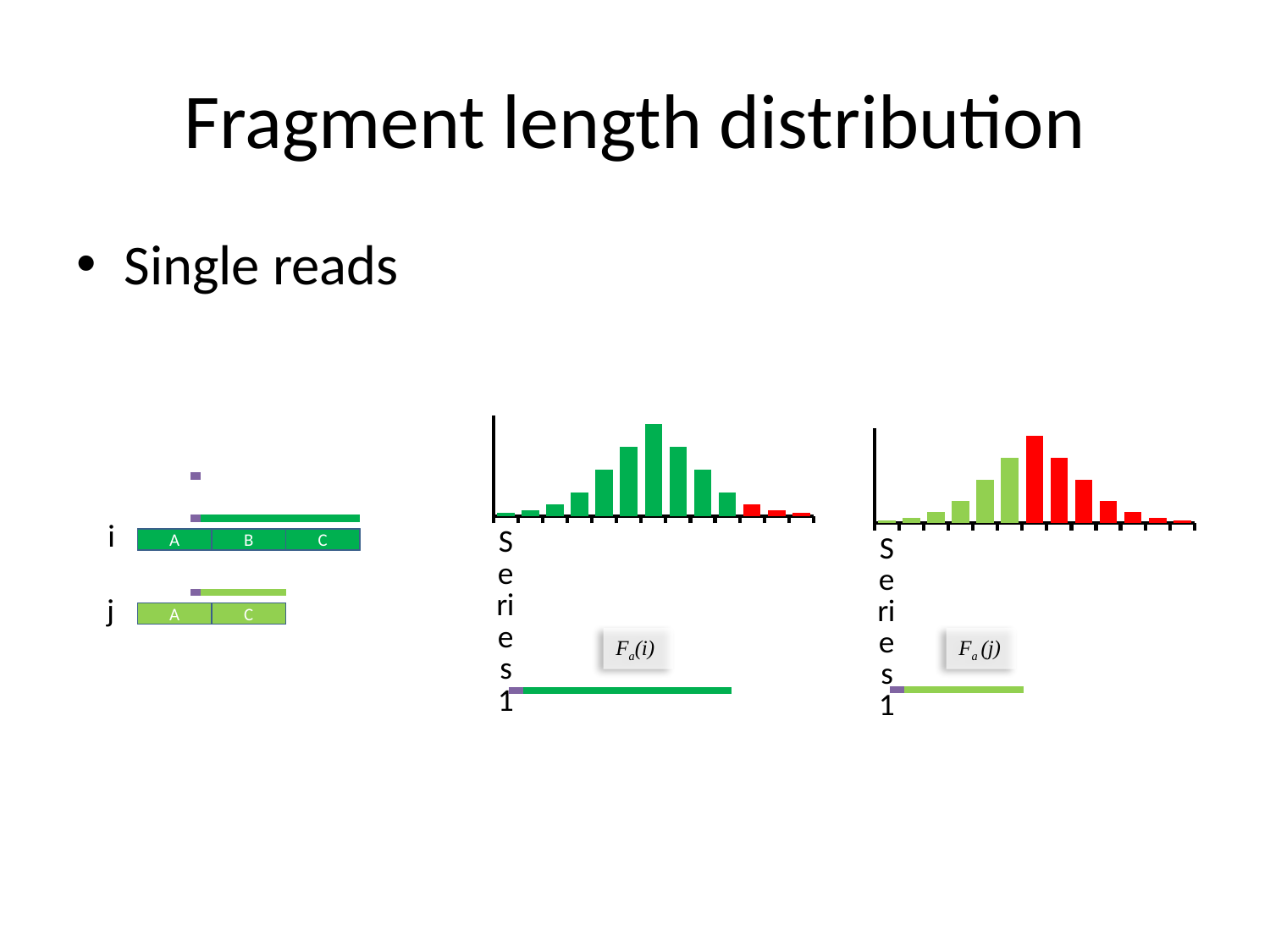
How many bars are plotted in the chart labelled F_a(i)? 13 What is the legend entry shown for the chart labelled F_a(j)? Series 1 In the chart labelled F_a(j), is the first (leftmost) bar taller or shorter than the tallest bar? shorter In the chart labelled F_a(i), are the red bars taller or shorter than the tallest green bar? shorter In the chart labelled F_a(i), do the bar heights rise or fall moving from the tallest bar toward the right edge of the axis? fall How many series does the legend of the chart labelled F_a(i) list? 1 What kind of chart is the chart labelled F_a(j)? bar chart What kind of chart is the chart labelled F_a(i)? bar chart In the chart labelled F_a(j), do the bar heights rise or fall moving from the left edge of the axis toward the tallest bar? rise In the chart labelled F_a(j), is the tallest bar green or red? red In the chart labelled F_a(i), is the tallest bar green or red? green What two colours are used for the bars in the chart labelled F_a(i)? green and red